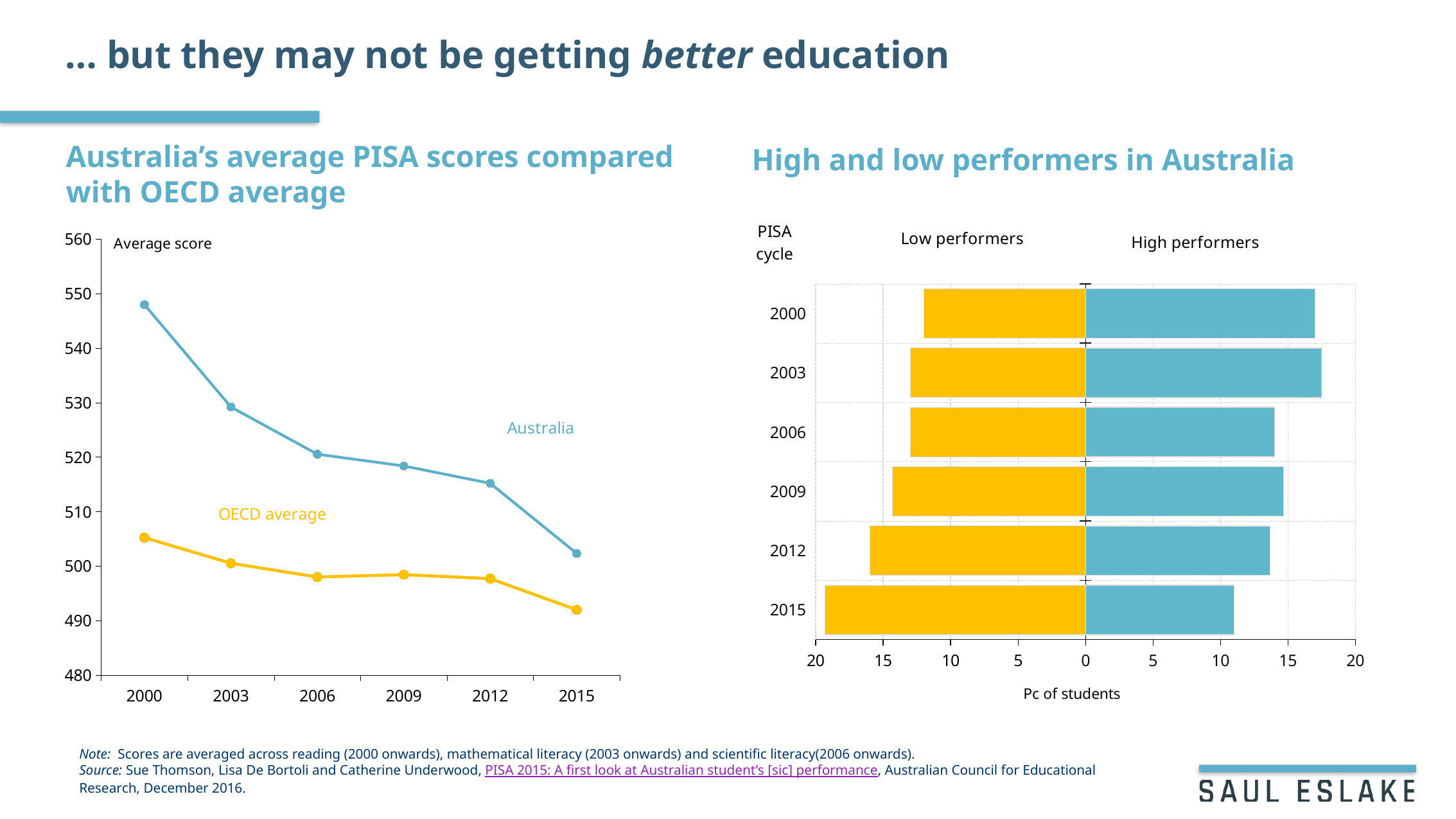
In the left chart, which is higher in 2015, Australia or the OECD average? Australia In the right chart, in 2000, which is larger, the percentage of low performers or high performers? High performers In the right chart, how many PISA cycles are shown? 6 In the right chart, which PISA cycle has the lowest percentage of high performers? 2015 In the left chart, in which year is Australia's average score highest? 2000 In the left chart, how many series are plotted? 2 In the left chart, is Australia's average score in 2000 greater or less than 540? greater What kind of chart is the right chart, 'High and low performers in Australia'? bar chart What kind of chart is the left chart, 'Australia's average PISA scores compared with OECD average'? line chart In the left chart, is the OECD average in 2015 greater or less than 500? less In the left chart, does Australia's average score rise or fall from 2000 to 2015? fall In the right chart, is the percentage of low performers in 2015 greater or less than 15? greater